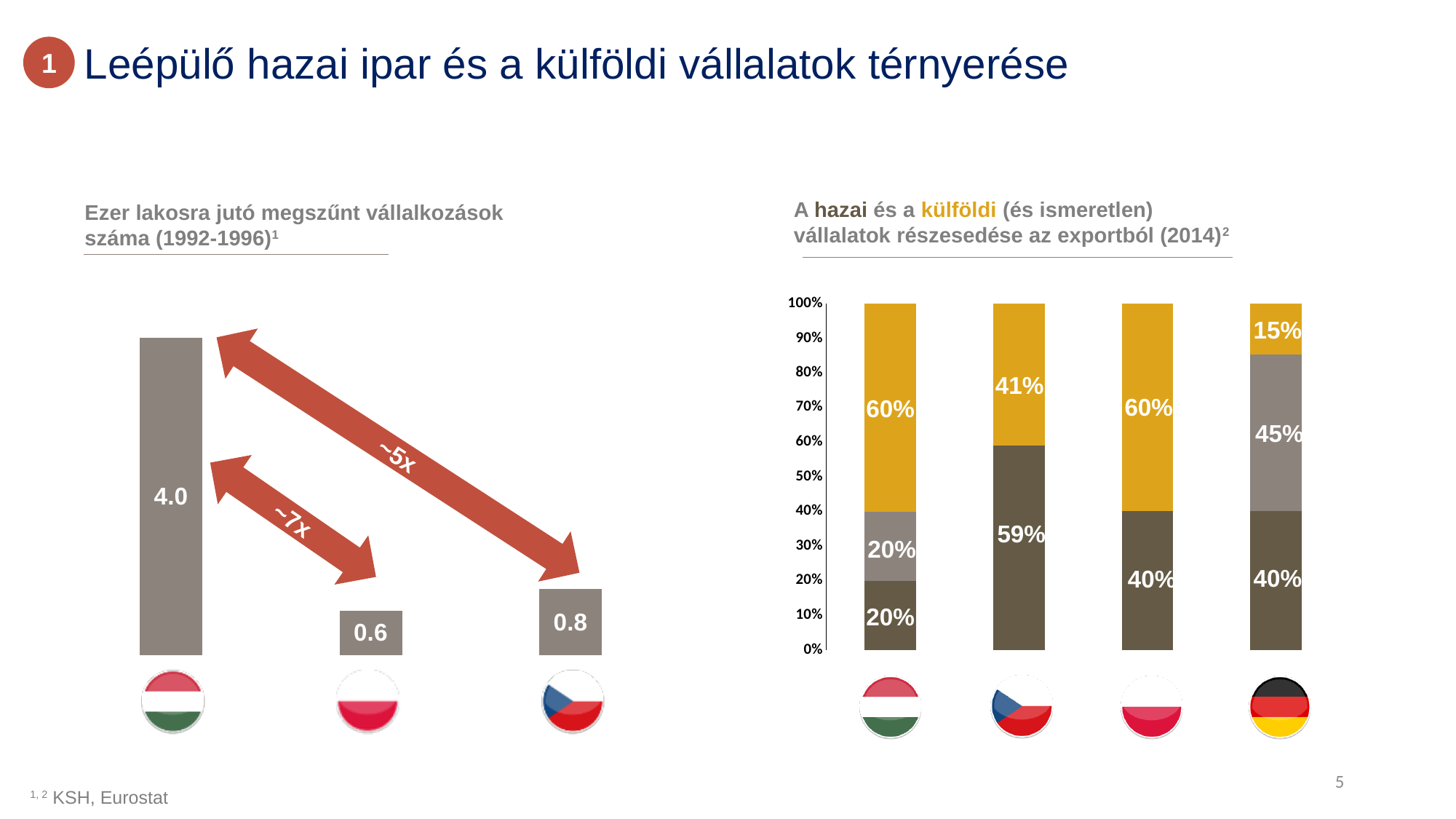
In the right chart (vállalatok részesedése az exportból), what is the külföldi (gold) share for the fourth bar (Germany)? 15% In the left chart (Ezer lakosra jutó megszűnt vállalkozások száma), which bar is the lowest? Poland (0.6) In the left chart (Ezer lakosra jutó megszűnt vállalkozások száma), what is the difference between the Hungary bar and the Czech Republic bar? 3.2 In the right chart (vállalatok részesedése az exportból), how many bars are shown? 4 In the left chart (Ezer lakosra jutó megszűnt vállalkozások száma), what is the value for the second bar (Poland)? 0.6 In the left chart (Ezer lakosra jutó megszűnt vállalkozások száma), how many bars are shown? 3 In the right chart (vállalatok részesedése az exportból), is the külföldi (gold) share for the third bar (Poland) larger or smaller than for the fourth bar (Germany)? Larger In the right chart (vállalatok részesedése az exportból), what is the külföldi (gold) share for the first bar (Hungary)? 60% What type of chart is the right chart (vállalatok részesedése az exportból)? Stacked bar chart In the right chart (vállalatok részesedése az exportból), what is the hazai (dark) share for the second bar (Czech Republic)? 59% In the left chart (Ezer lakosra jutó megszűnt vállalkozások száma), what is the value for the first bar (Hungary)? 4.0 In the right chart (vállalatok részesedése az exportból), which bar has the highest hazai (dark) share? Czech Republic (59%)